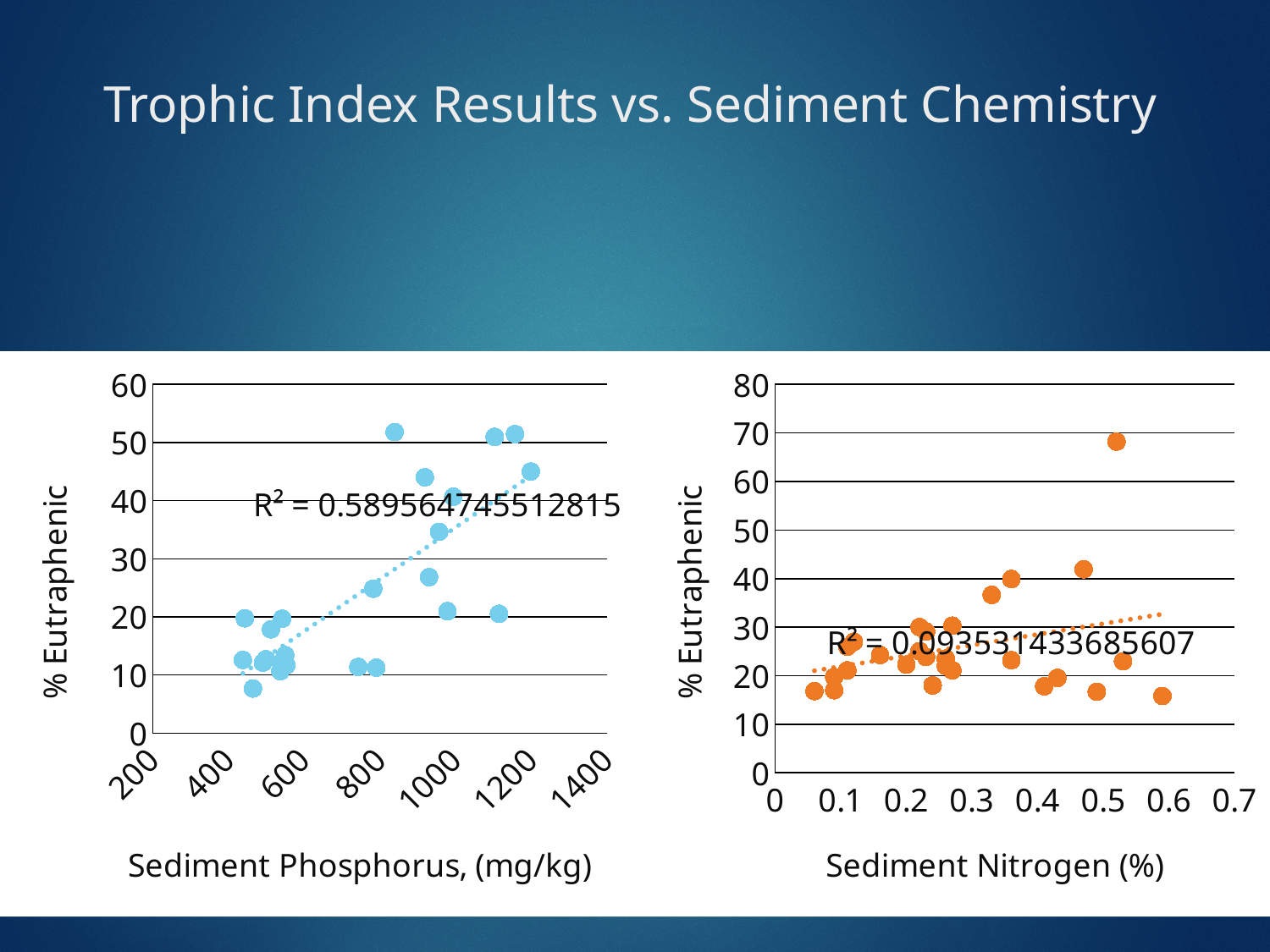
In the right chart, is the highest plotted % Eutraphenic value greater or less than 60? greater In the right chart, what R² value is printed for the trendline? R² = 0.0935314336685607 In the right chart, does the dotted trendline rise or fall as Sediment Nitrogen increases? rise In the left chart, does the dotted trendline rise or fall as Sediment Phosphorus increases? rise Which chart has the higher R² value, the Sediment Phosphorus chart or the Sediment Nitrogen chart? Sediment Phosphorus chart What is the maximum value shown on the y axis of the right chart? 80 What kind of chart is the left chart (Sediment Phosphorus)? scatter chart In the left chart, is the lowest plotted % Eutraphenic value greater or less than 10? less In the left chart, is the highest plotted % Eutraphenic value greater or less than 50? greater In the left chart, what R² value is printed for the trendline? R² = 0.589564745512815 What kind of chart is the right chart (Sediment Nitrogen)? scatter chart